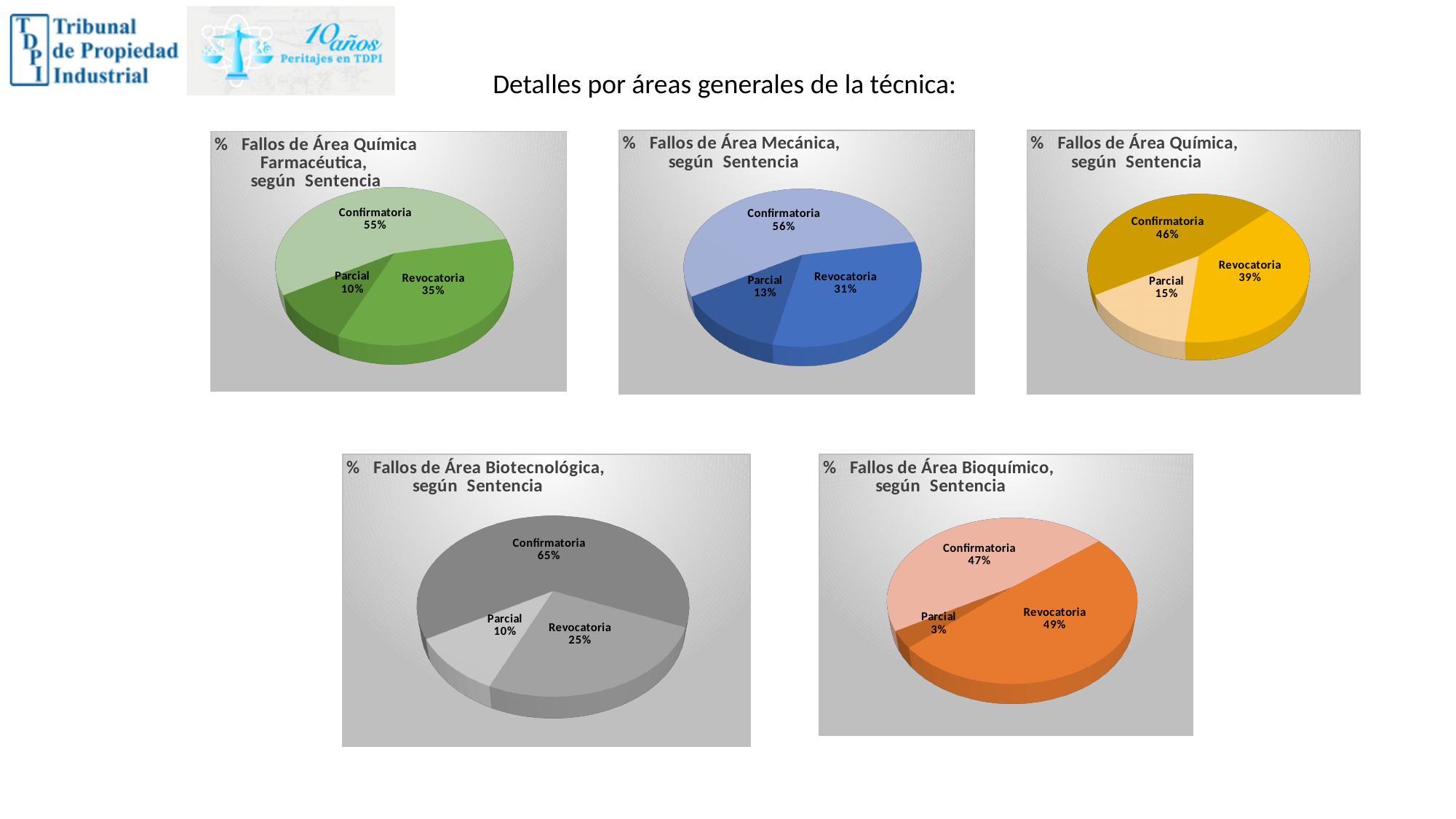
How many slices does the 'Fallos de Área Mecánica, según Sentencia' chart have? 3 In the 'Fallos de Área Bioquímico, según Sentencia' chart, which is larger, Confirmatoria or Revocatoria? Revocatoria In the 'Fallos de Área Mecánica, según Sentencia' chart, what percentage is Parcial? 13% In the 'Fallos de Área Bioquímico, según Sentencia' chart, which category has the smallest share? Parcial What type of chart is the 'Fallos de Área Biotecnológica, según Sentencia' chart? Pie chart In the 'Fallos de Área Química, según Sentencia' chart, what percentage is Revocatoria? 39% How many charts are shown on the slide? 5 In the 'Fallos de Área Química Farmacéutica, según Sentencia' chart, what percentage is Confirmatoria? 55% In the 'Fallos de Área Biotecnológica, según Sentencia' chart, what is the difference between Confirmatoria and Revocatoria? 40% In the 'Fallos de Área Biotecnológica, según Sentencia' chart, which category has the largest share? Confirmatoria In the 'Fallos de Área Química, según Sentencia' chart, what is the difference between Confirmatoria and Revocatoria? 7% In the 'Fallos de Área Bioquímico, según Sentencia' chart, what percentage is Parcial? 3%